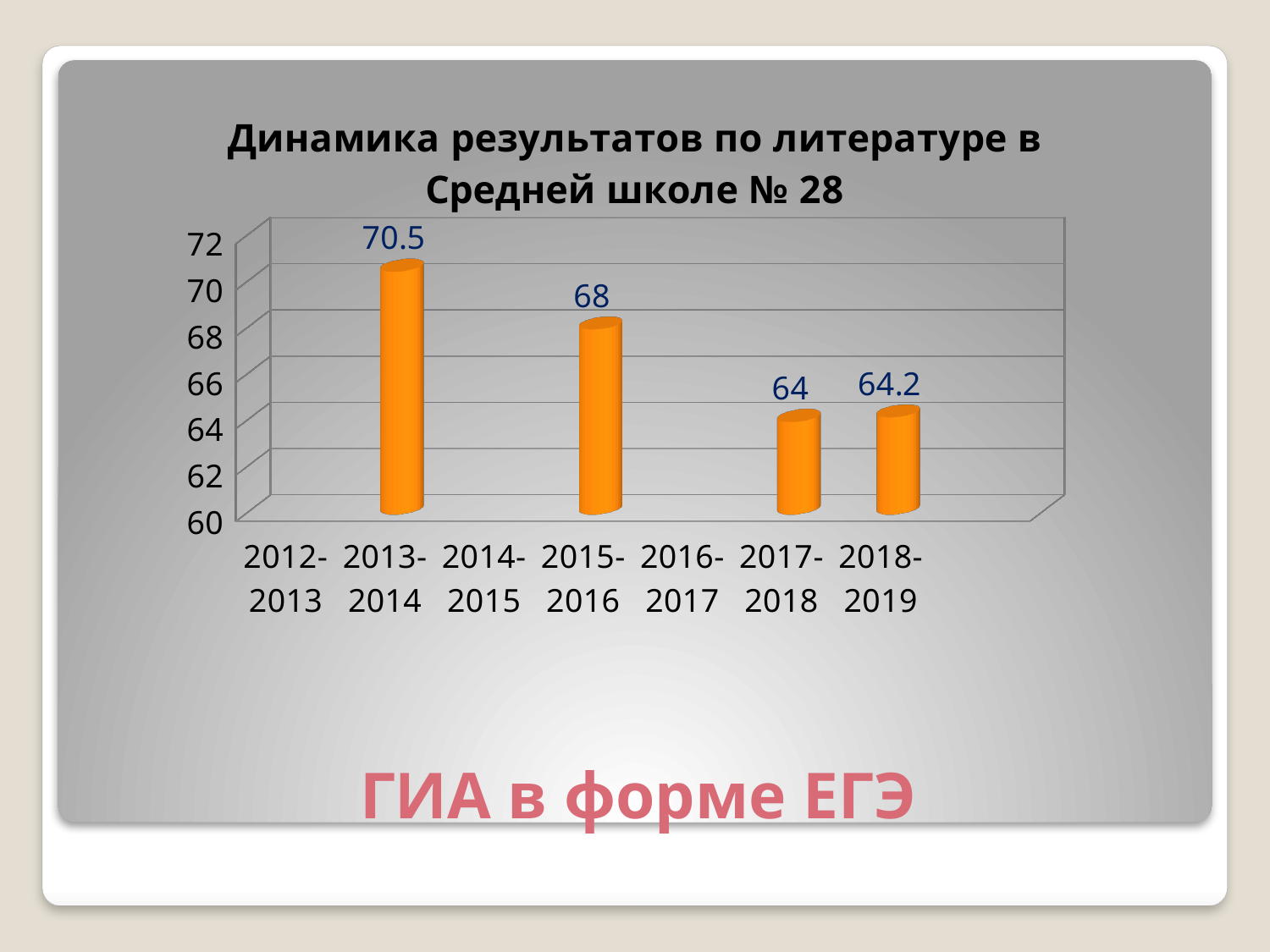
What is the difference between the values for 2018-2019 and 2017-2018? 0.2 What kind of chart is shown? bar chart Do the values generally rise or fall from 2013-2014 to 2018-2019? fall What is the value for 2015-2016? 68 What is the value for 2018-2019? 64.2 How many bars are plotted on the chart? 4 Which year with a plotted bar has the lowest value? 2017-2018 Which year has the highest value? 2013-2014 Which is larger, the value for 2017-2018 or the value for 2018-2019? 2018-2019 What is the value for 2017-2018? 64 What is the value for 2013-2014? 70.5 What is the difference between the values for 2013-2014 and 2015-2016? 2.5